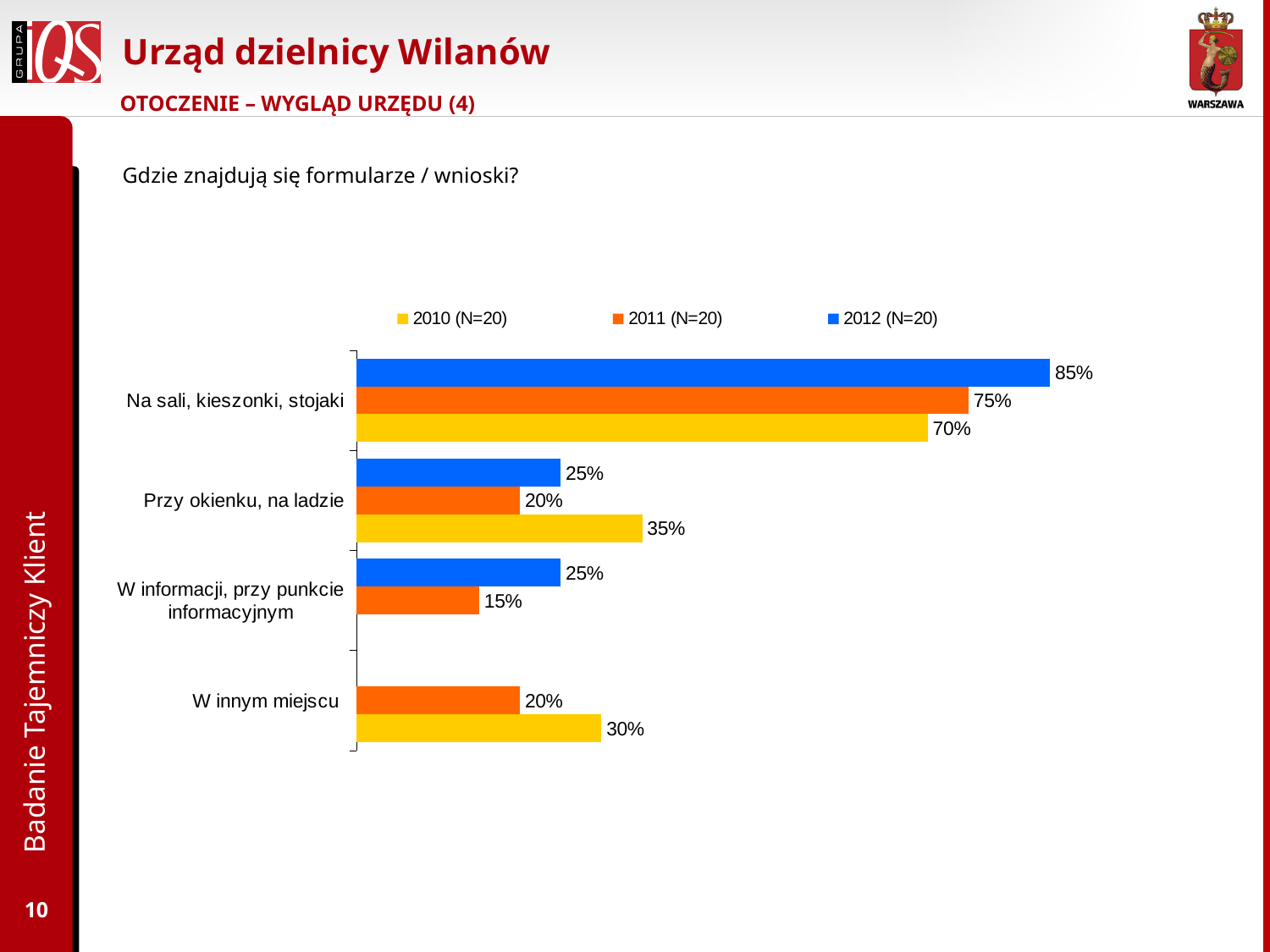
What colour represents the 2011 (N=20) series in the chart? Orange What is the value for 'W informacji, przy punkcie informacyjnym' in the 2011 (N=20) series? 15% Which category has the lowest value in the 2011 (N=20) series? W informacji, przy punkcie informacyjnym How many categories are shown on the chart? 4 What is the value for 'Przy okienku, na ladzie' in the 2010 (N=20) series? 35% What is the value for 'W innym miejscu' in the 2010 (N=20) series? 30% What is the value for 'Na sali, kieszonki, stojaki' in the 2012 (N=20) series? 85% For 'Przy okienku, na ladzie', which series has the larger value: 2010 (N=20) or 2012 (N=20)? 2010 (N=20) How many series does the legend list? 3 Which category has the highest value in the 2011 (N=20) series? Na sali, kieszonki, stojaki What kind of chart is shown on the slide? Bar chart What is the difference between the 2012 (N=20) and 2010 (N=20) values for 'Na sali, kieszonki, stojaki'? 15%